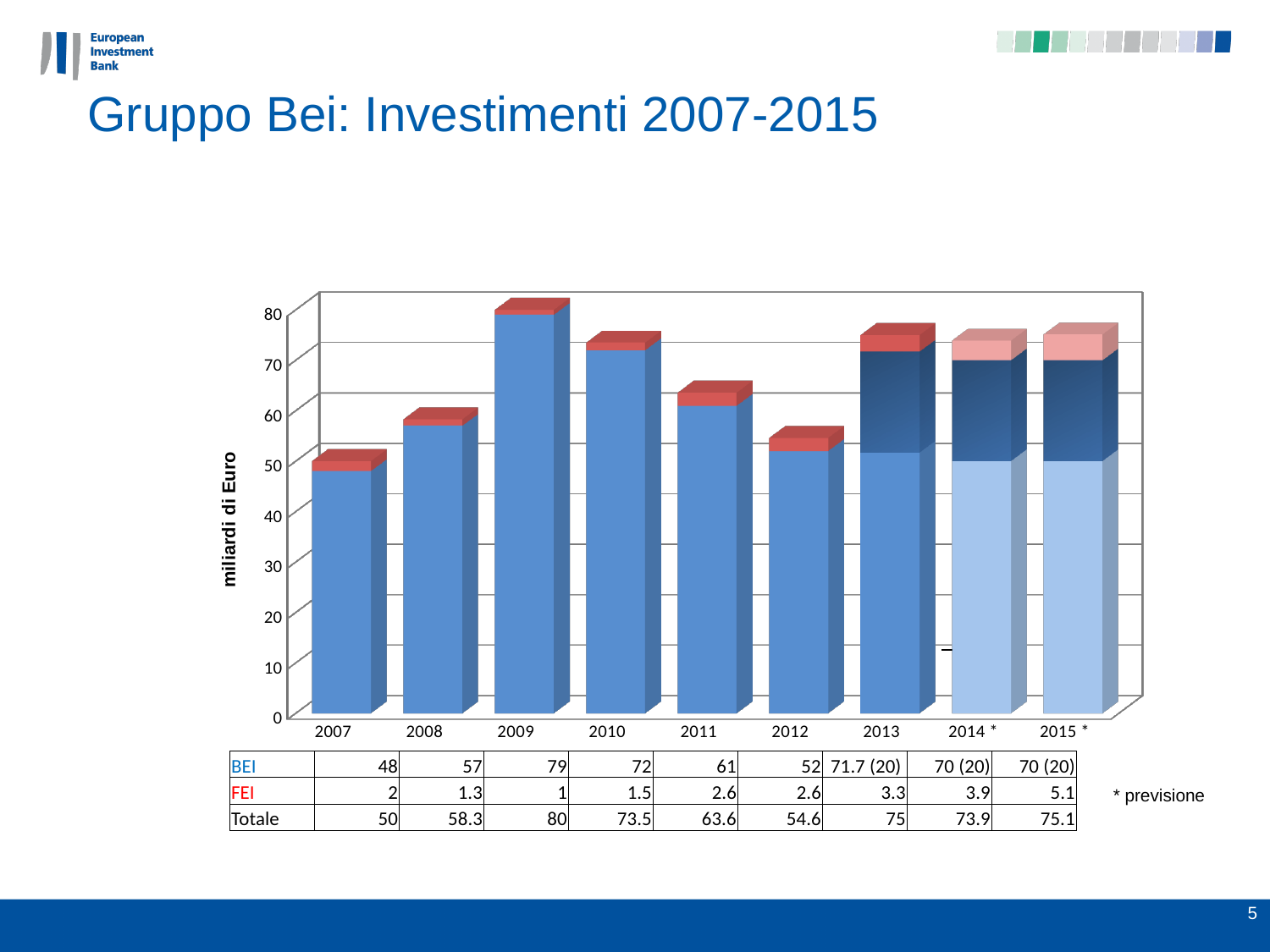
What is the Totale value for 2012? 54.6 What kind of chart is shown on the slide? Stacked bar chart Which year has the lowest FEI value? 2009 Which year has the highest Totale value? 2009 Which year has the lowest Totale value? 2007 What is the BEI value for 2009? 79 What is the label of the y axis? miliardi di Euro What is the total of the stacked bar for 2013? 75 How many years are shown on the x axis? 9 What is the FEI value for 2011? 2.6 Which is larger, the BEI value for 2008 or the BEI value for 2010? 2010 What is the difference between the BEI value for 2009 and the BEI value for 2012? 27